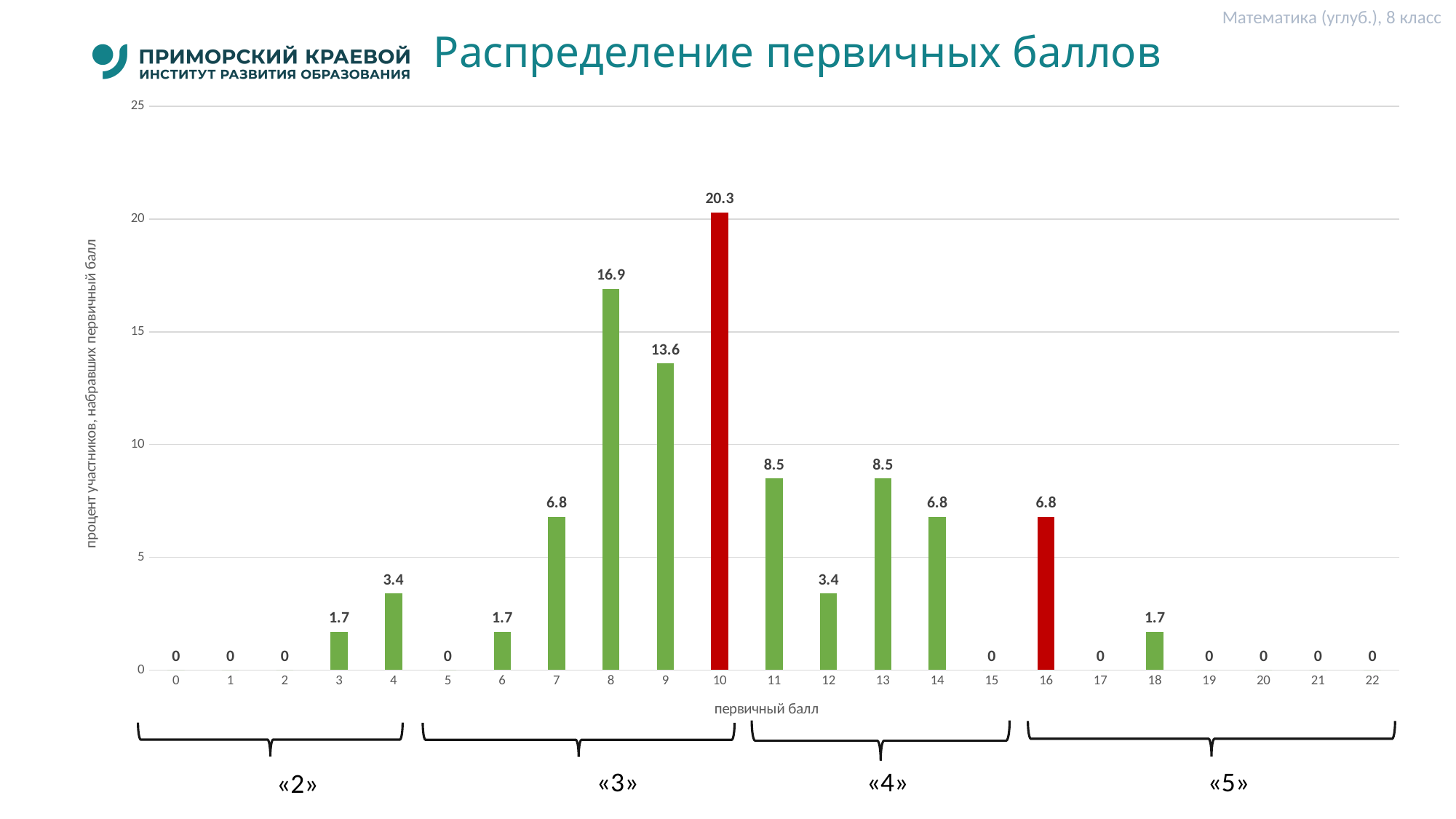
What kind of chart is shown on the slide? bar chart What is the value for primary score 16? 6.8 What is the difference between the values for primary scores 10 and 9? 6.7 Which is larger, the value for primary score 8 or for primary score 11? 8 What is the title of the chart? Распределение первичных баллов What is the value for primary score 10? 20.3 Which primary score has the highest percentage of participants? 10 Is the value for primary score 9 greater or less than 10? greater What colour are the bars for primary scores 10 and 16? red How many primary score categories are shown on the x axis? 23 What is the value for primary score 8? 16.9